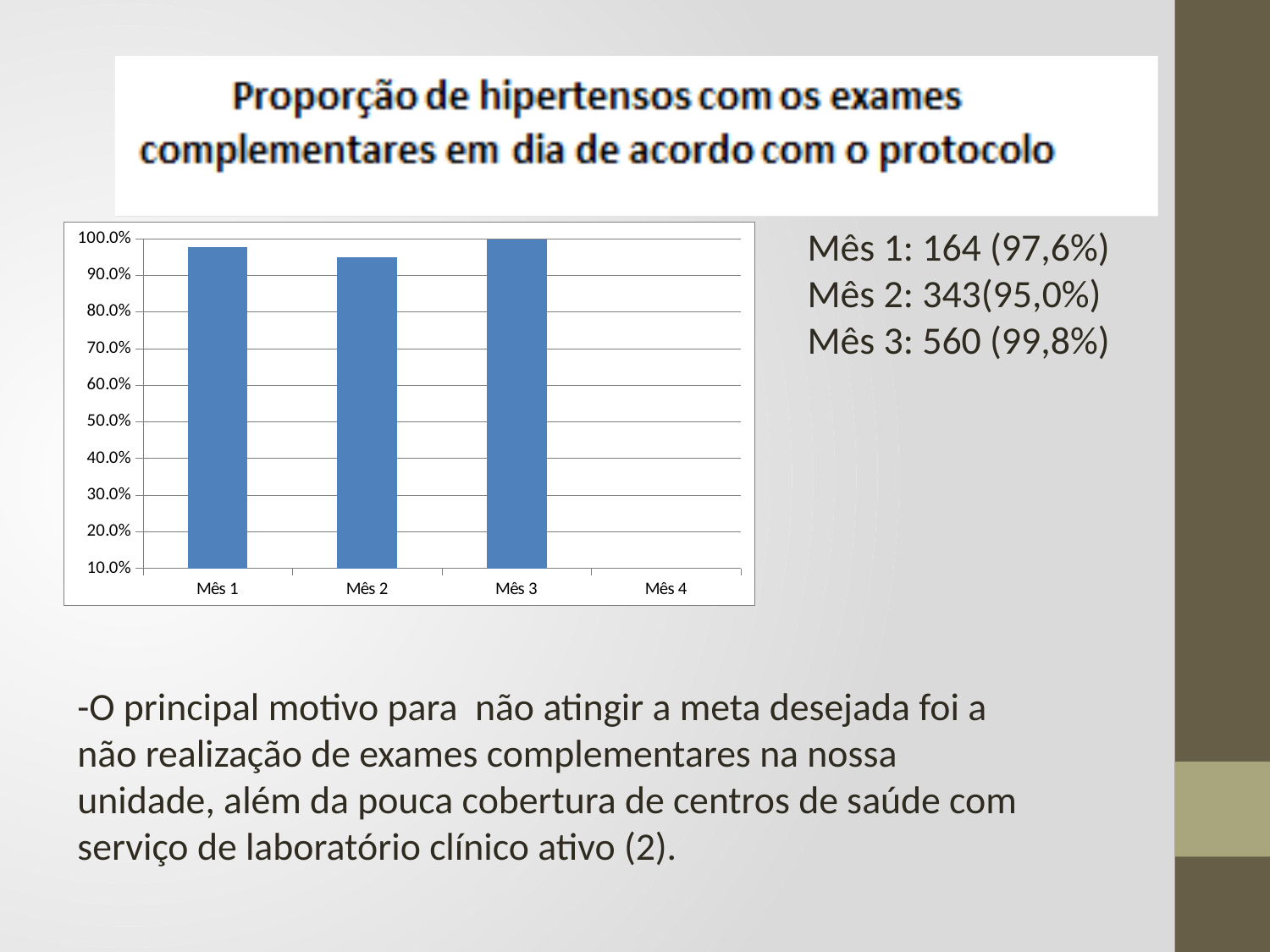
Does the value rise or fall from Mês 2 to Mês 3? rise Which is larger, the value for Mês 1 or the value for Mês 2? Mês 1 Which month has the highest bar in the chart? Mês 3 According to the slide, what is the proportion for Mês 1? 97,6% Is the value for Mês 2 greater or less than 90.0%? greater Which of the plotted months has the lowest bar in the chart? Mês 2 How many categories are shown on the x axis of the chart? 4 What kind of chart is shown on the slide? bar chart How many bars are plotted in the chart? 3 What is the title of the chart? Proporção de hipertensos com os exames complementares em dia de acordo com o protocolo According to the slide, what is the proportion for Mês 2? 95,0% According to the slide, what is the proportion for Mês 3? 99,8%